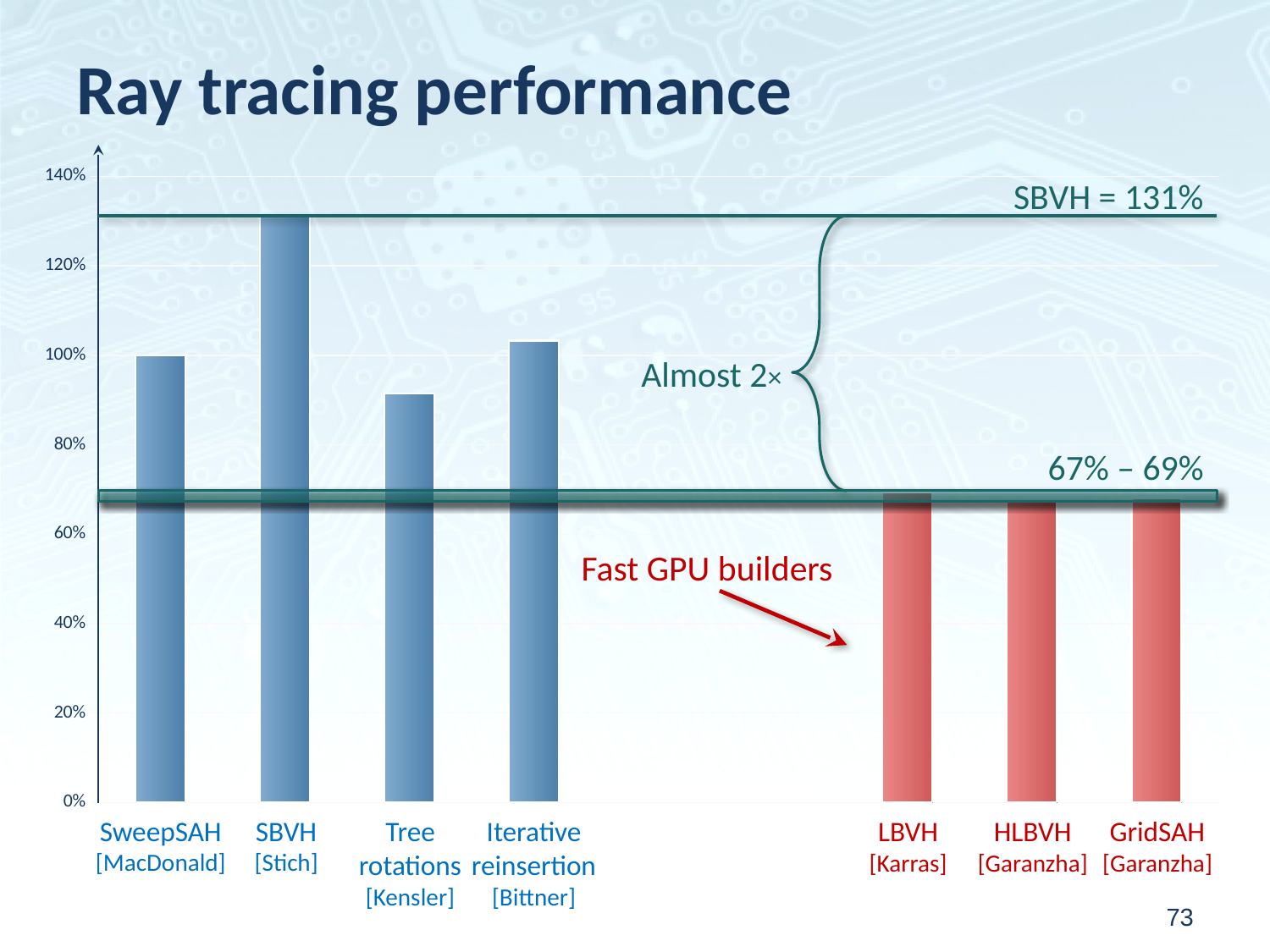
Is the value for LBVH greater or less than 80%? less What is the title of the slide's chart? Ray tracing performance Is the value for Tree rotations greater or less than 100%? less Which bars does the label "Fast GPU builders" refer to? LBVH, HLBVH, GridSAH What is the ray tracing performance value given for SBVH? 131% How many bars are plotted in the chart? 7 Which is larger, the value for SBVH or the value for Iterative reinsertion? SBVH What kind of chart is shown on the slide? bar chart Which method has the highest ray tracing performance in the chart? SBVH Is the value for Iterative reinsertion greater or less than 100%? greater Which is larger, the value for Tree rotations or the value for Iterative reinsertion? Iterative reinsertion